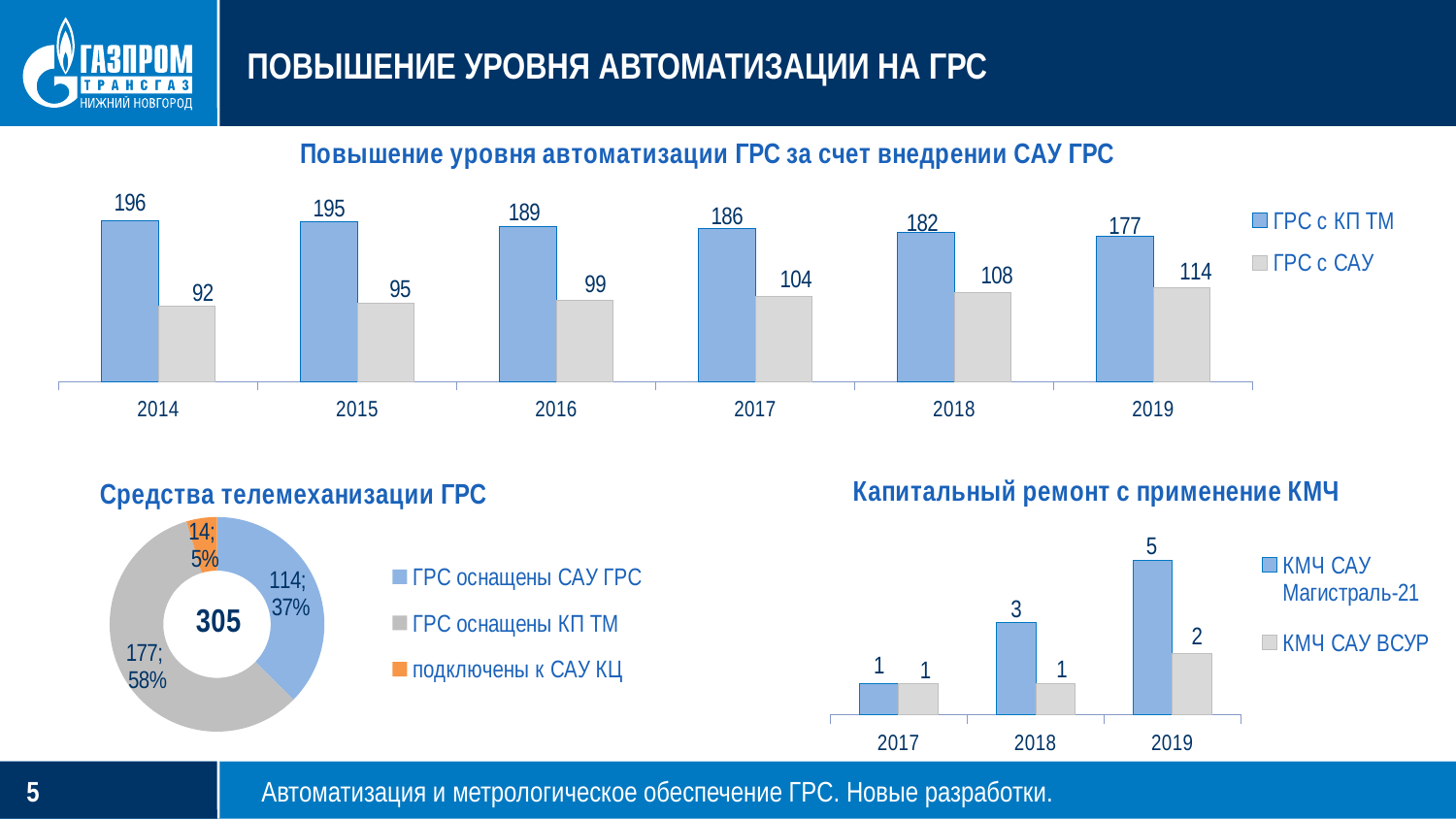
In the chart 'Повышение уровня автоматизации ГРС за счет внедрении САУ ГРС', what is the value for 'ГРС с КП ТМ' in 2019? 177 In the chart 'Повышение уровня автоматизации ГРС за счет внедрении САУ ГРС', what is the value for 'ГРС с САУ' in 2017? 104 In the chart 'Повышение уровня автоматизации ГРС за счет внедрении САУ ГРС', which year has the highest value for 'ГРС с САУ'? 2019 In the chart 'Повышение уровня автоматизации ГРС за счет внедрении САУ ГРС', what is the difference between 'ГРС с КП ТМ' and 'ГРС с САУ' in 2014? 104 In the chart 'Средства телемеханизации ГРС', what total is shown in the centre of the doughnut? 305 What kind of chart is 'Средства телемеханизации ГРС'? doughnut chart In the chart 'Капитальный ремонт с применение КМЧ', what is the value for 'КМЧ САУ Магистраль-21' in 2019? 5 In the chart 'Капитальный ремонт с применение КМЧ', which is larger in 2018: 'КМЧ САУ Магистраль-21' or 'КМЧ САУ ВСУР'? КМЧ САУ Магистраль-21 How many years are shown on the x axis of the chart 'Повышение уровня автоматизации ГРС за счет внедрении САУ ГРС'? 6 In the chart 'Средства телемеханизации ГРС', what share is shown for 'ГРС оснащены КП ТМ'? 58% How many series does the legend of the chart 'Повышение уровня автоматизации ГРС за счет внедрении САУ ГРС' list? 2 In the chart 'Повышение уровня автоматизации ГРС за счет внедрении САУ ГРС', does the 'ГРС с КП ТМ' series rise or fall from 2014 to 2019? fall